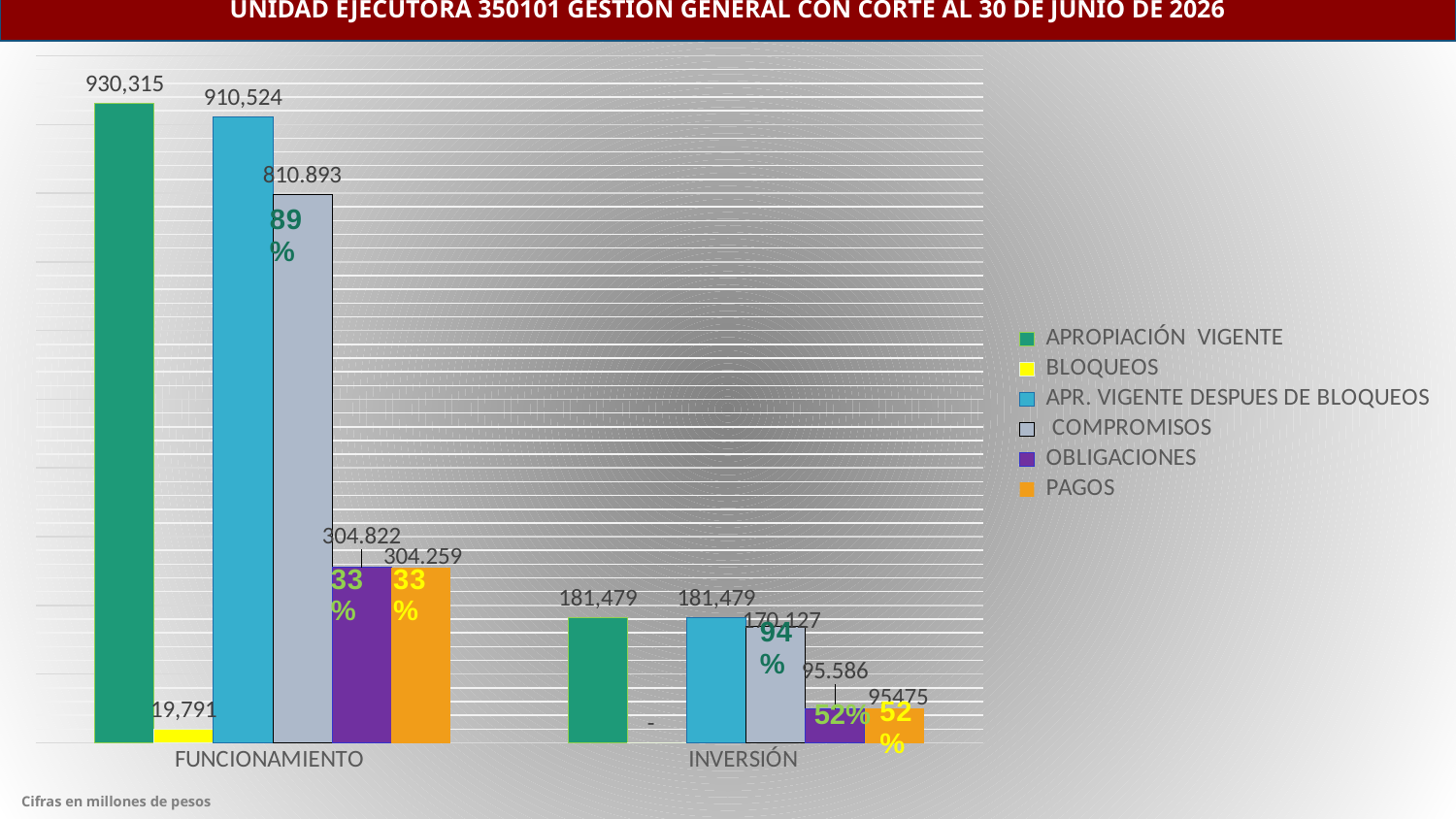
What kind of chart is shown on the slide? Bar chart What is the value of BLOQUEOS for FUNCIONAMIENTO? 19,791 How many categories are shown on the x axis? 2 How many series does the legend list? 6 Which category has the larger APROPIACIÓN VIGENTE value, FUNCIONAMIENTO or INVERSIÓN? FUNCIONAMIENTO What is the value of OBLIGACIONES for INVERSIÓN? 95.586 What is the value of PAGOS for FUNCIONAMIENTO? 304.259 What is the value of APROPIACIÓN VIGENTE for FUNCIONAMIENTO? 930,315 What is the value of COMPROMISOS for INVERSIÓN? 170.127 Which series has the lowest value for FUNCIONAMIENTO? BLOQUEOS What is the difference between APROPIACIÓN VIGENTE and APR. VIGENTE DESPUES DE BLOQUEOS for FUNCIONAMIENTO? 19,791 What percentage label is shown on the COMPROMISOS bar for INVERSIÓN? 94%